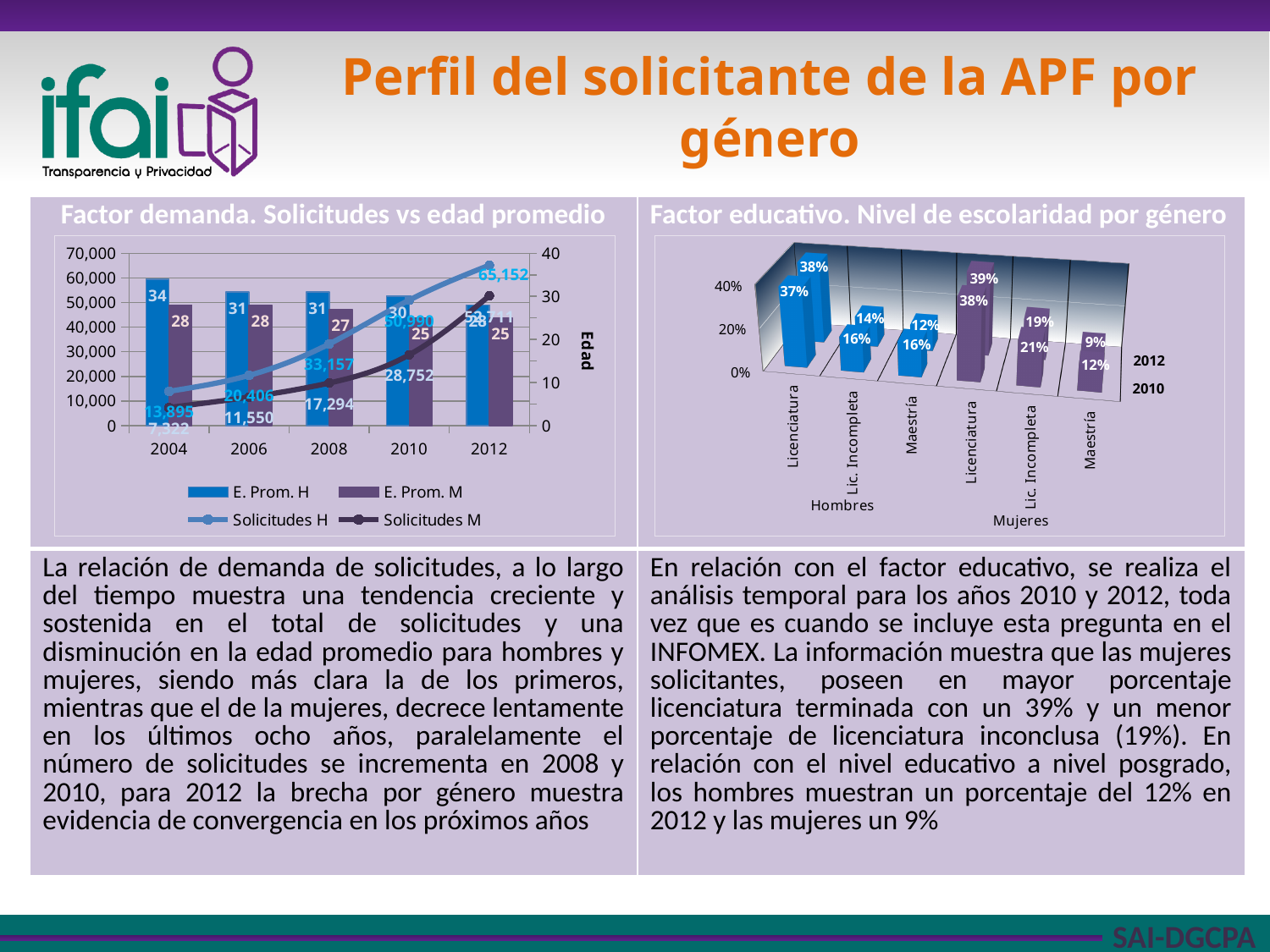
In the chart 'Factor demanda. Solicitudes vs edad promedio', in which year is Solicitudes H highest? 2012 In the chart 'Factor demanda. Solicitudes vs edad promedio', how many series does the legend list? 4 In the chart 'Factor educativo. Nivel de escolaridad por género', which two years does the legend list? 2012 and 2010 In the chart 'Factor demanda. Solicitudes vs edad promedio', what is the value of Solicitudes M for 2008? 17,294 In the chart 'Factor demanda. Solicitudes vs edad promedio', what is the value of E. Prom. H for 2004? 34 In the chart 'Factor educativo. Nivel de escolaridad por género', what is the 2012 value for Licenciatura among Mujeres? 39% In the chart 'Factor demanda. Solicitudes vs edad promedio', what is the difference between Solicitudes H and Solicitudes M in 2010? 22,238 In the chart 'Factor demanda. Solicitudes vs edad promedio', what is the value of Solicitudes H for 2012? 65,152 In the chart 'Factor educativo. Nivel de escolaridad por género', what is the 2010 value for Lic. Incompleta among Hombres? 16% In the chart 'Factor demanda. Solicitudes vs edad promedio', does Solicitudes H rise or fall from 2004 to 2012? rise In the chart 'Factor educativo. Nivel de escolaridad por género', which is larger in 2012: Maestría for Hombres or Maestría for Mujeres? Maestría for Hombres In the chart 'Factor demanda. Solicitudes vs edad promedio', how many years are shown on the x axis? 5